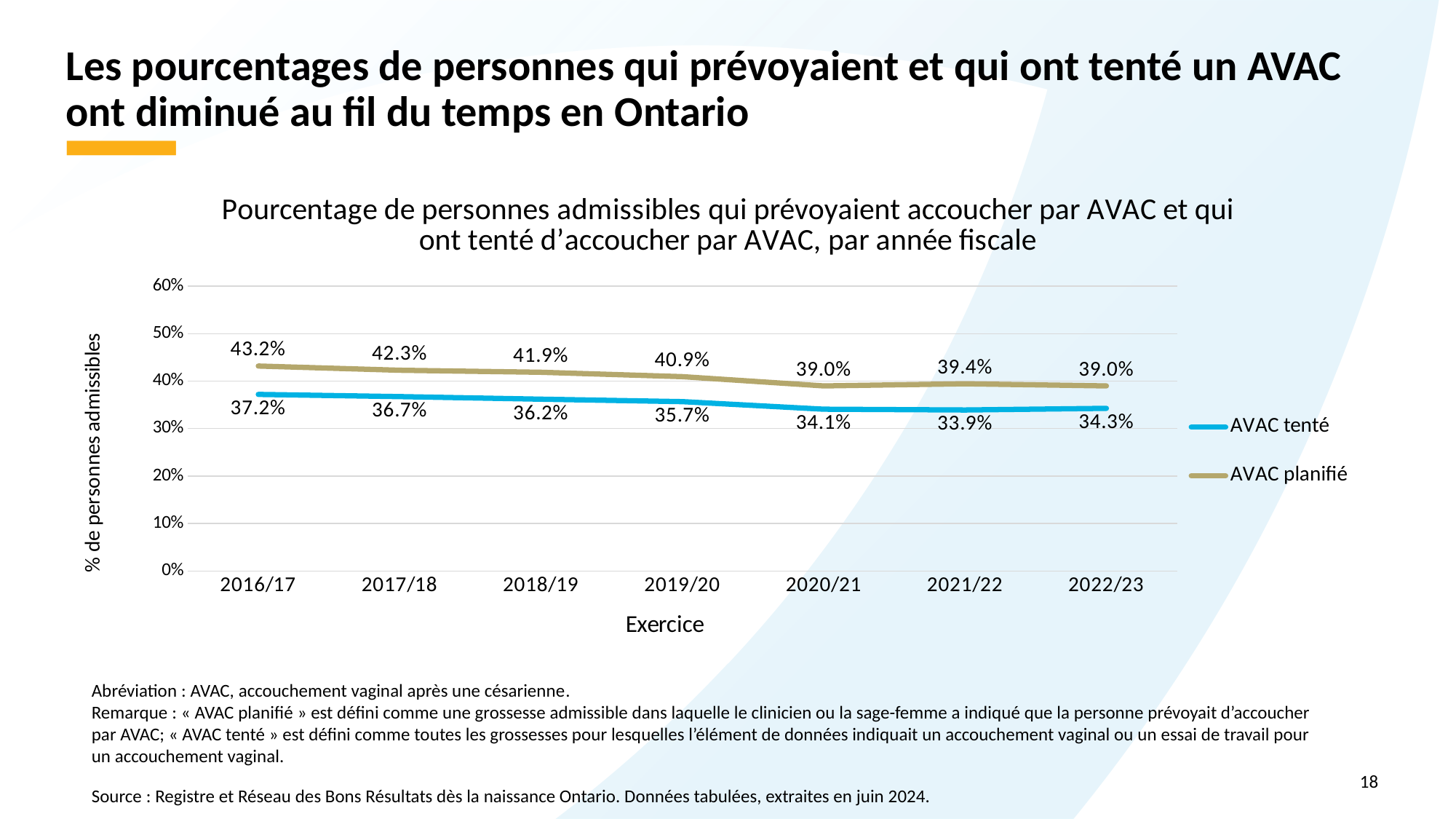
What is the difference between AVAC planifié and AVAC tenté in 2020/21? 4.9 percentage points What was the value for AVAC tenté in 2019/20? 35.7% What kind of chart is shown on the slide? Line chart How many fiscal years are shown on the x axis? 7 Does AVAC tenté generally rise or fall from 2016/17 to 2022/23? Fall In which fiscal year was AVAC planifié at its highest? 2016/17 Which series has the higher value in 2018/19, AVAC tenté or AVAC planifié? AVAC planifié What was the value for AVAC tenté in 2022/23? 34.3% By how much did AVAC planifié decrease from 2016/17 to 2022/23? 4.2 percentage points What was the value for AVAC planifié in 2016/17? 43.2% How many series does the legend list? 2 In which fiscal year was AVAC tenté at its lowest? 2021/22